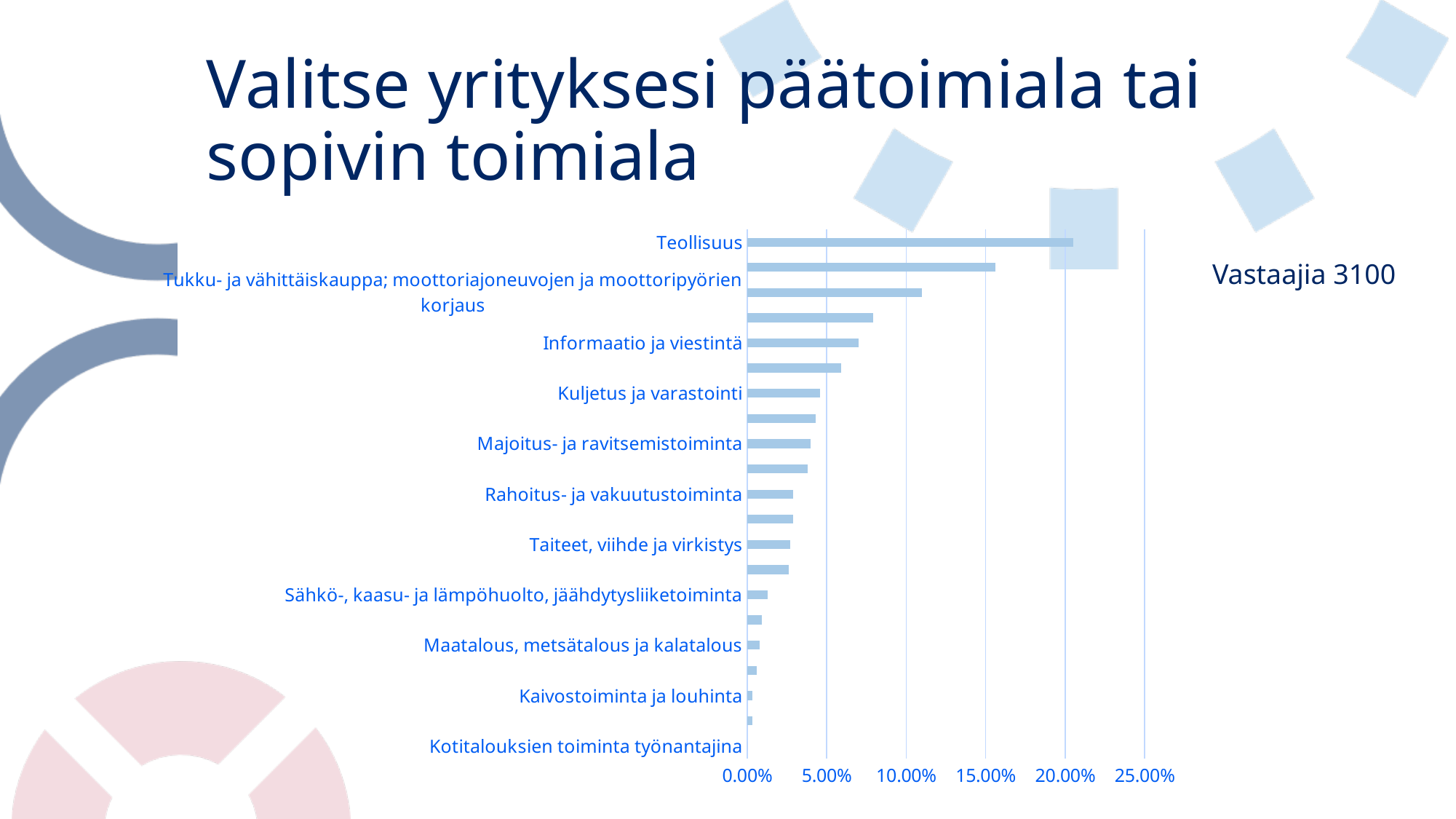
Is the value for Teollisuus greater or less than 15.00%? greater Is the value for Rahoitus- ja vakuutustoiminta greater or less than 5.00%? less Is the value for Kuljetus ja varastointi greater or less than 10.00%? less Which has a larger value, Kuljetus ja varastointi or Maatalous, metsätalous ja kalatalous? Kuljetus ja varastointi Which category has the highest value in the chart? Teollisuus What kind of chart is shown on the slide? bar chart Do the bar values increase or decrease going from the top of the chart to the bottom? decrease How many respondents (Vastaajia) does the slide state? 3100 Which has a larger value, Teollisuus or Informaatio ja viestintä? Teollisuus What is the highest value shown on the horizontal axis of the chart? 25.00%